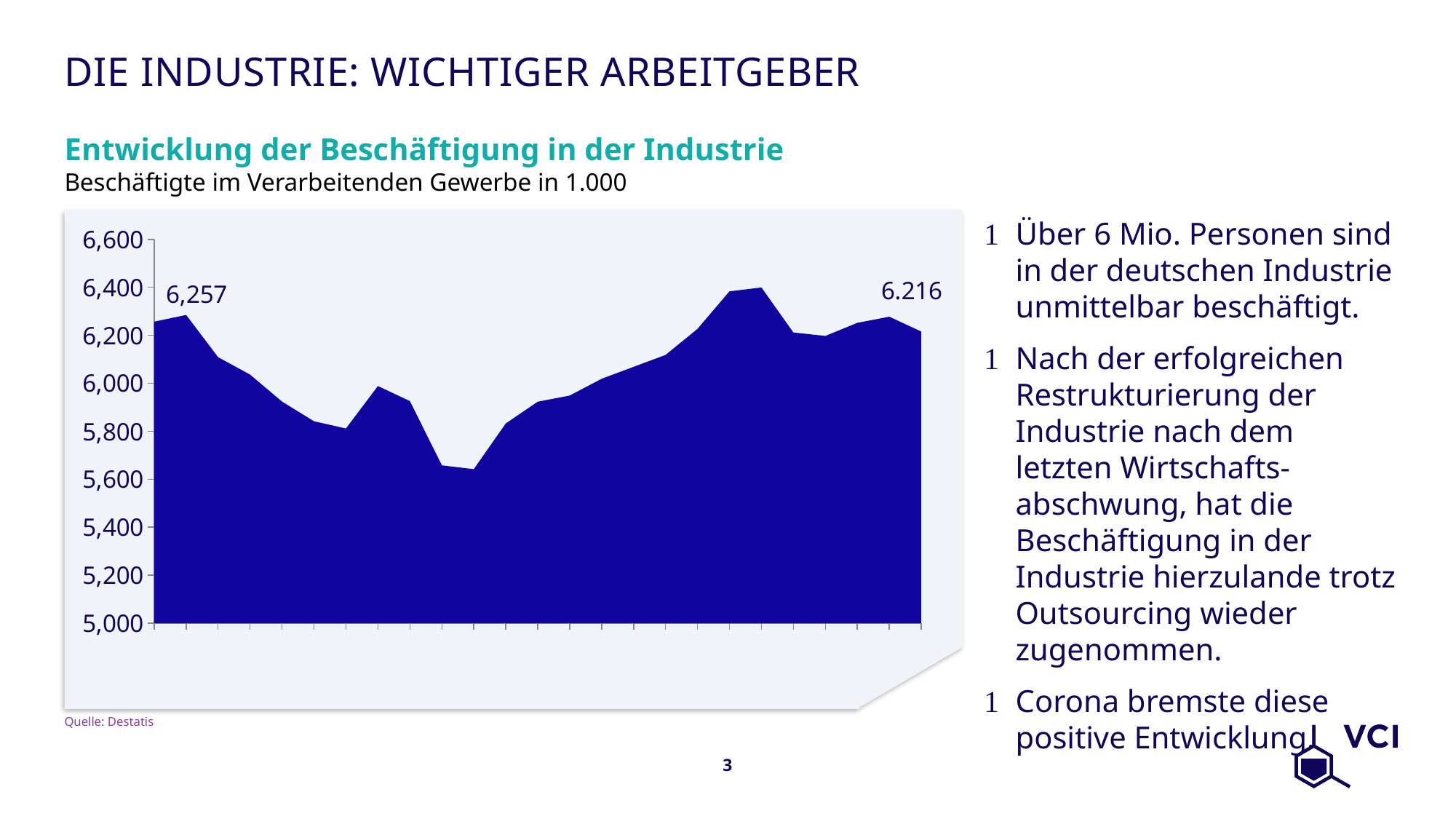
What kind of chart is shown on the slide? area chart By how much does the labelled start value exceed the labelled end value? 41 Is the value at the start of the series greater or less than 6,200? greater What is the value labelled at the start of the series in the chart? 6,257 Which is larger, the value at the start of the series or the value at the end? the start (6,257) Is the value at the end of the series greater or less than 6,000? greater What is the value labelled at the end of the series in the chart? 6.216 Is the lowest point of the series greater or less than 5,800? less What is the title of the chart? Entwicklung der Beschäftigung in der Industrie What is the highest tick value shown on the vertical axis? 6,600